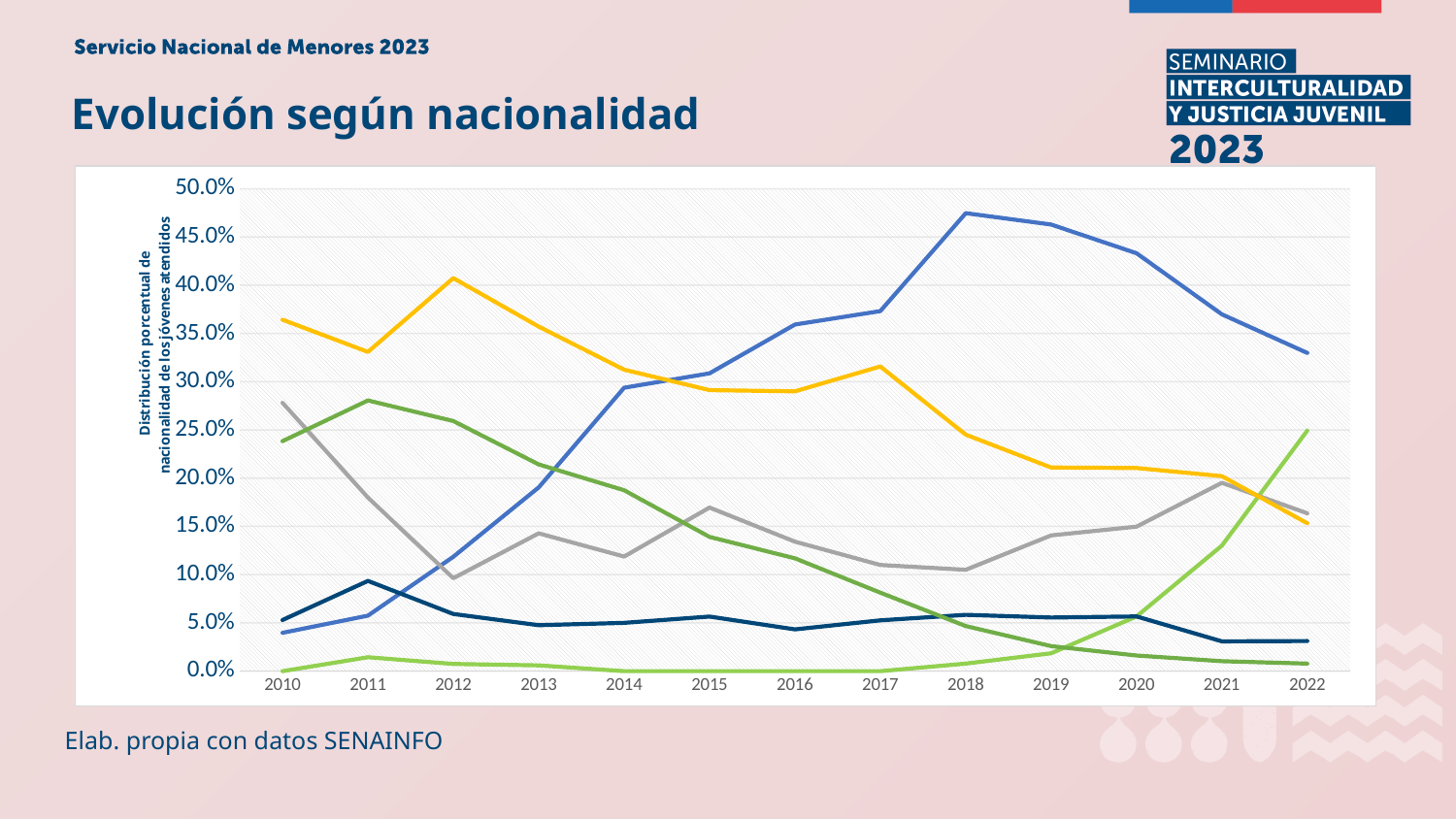
What is the title of the slide's chart section? Evolución según nacionalidad Is the value of the yellow line in 2012 greater or less than 35.0%? greater Is the value of the blue line in 2018 greater or less than 45.0%? greater In which year does the blue line reach its highest value? 2018 What kind of chart is shown on the slide? line chart In 2022, which is larger: the value of the blue line or the value of the yellow line? blue line Does the blue line rise or fall between 2010 and 2018? rise Is the value of the grey line in 2012 greater or less than 15.0%? less How many years are shown along the x axis of the chart? 13 Does the yellow line rise or fall between 2017 and 2022? fall What is the label on the y axis of the chart? Distribución porcentual de nacionalidad de los jóvenes atendidos